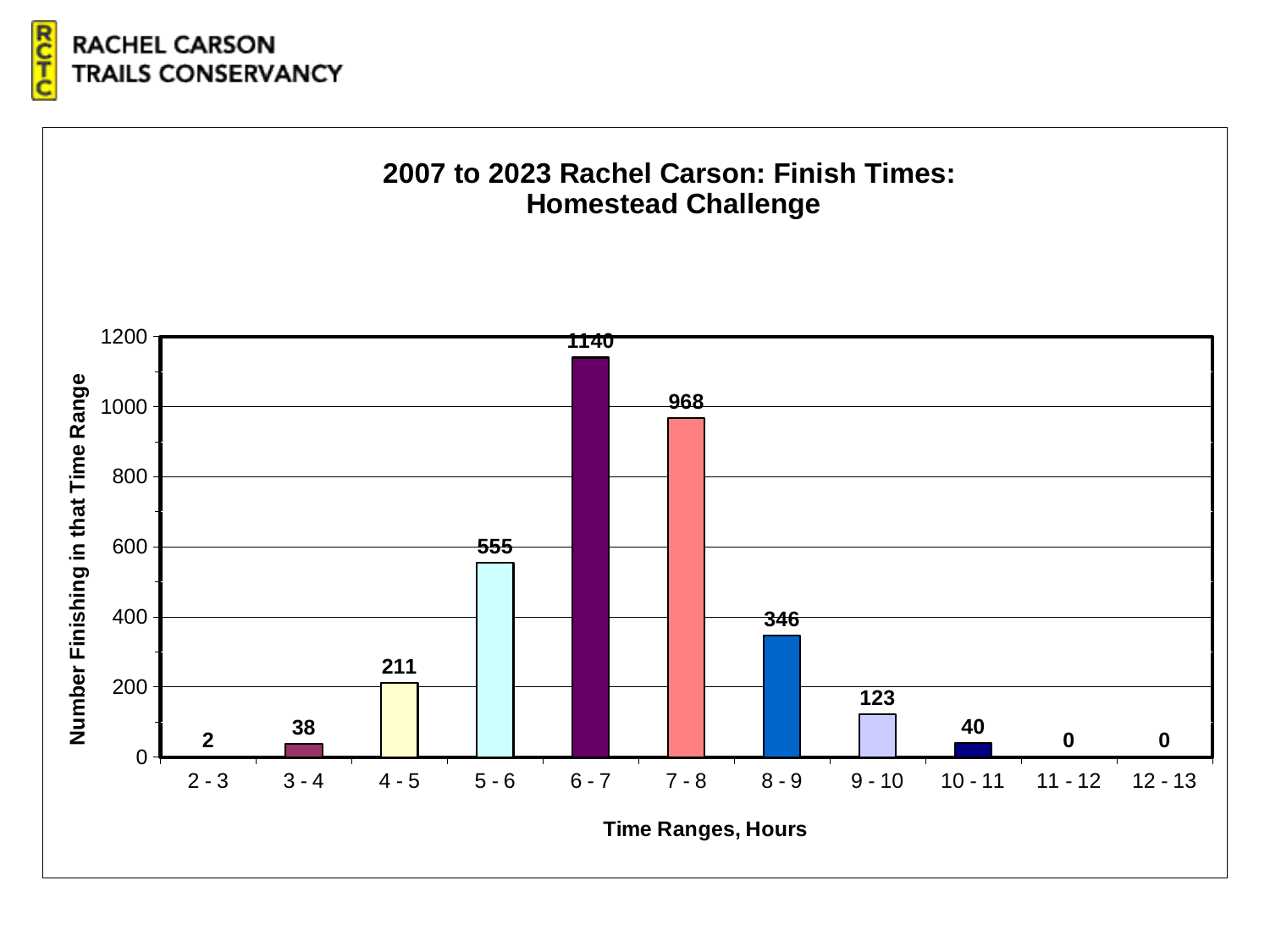
What is the title of the chart? 2007 to 2023 Rachel Carson: Finish Times: Homestead Challenge How many time range categories are shown on the x axis? 11 What is the difference between the number of finishers in the 6 - 7 and 7 - 8 hour ranges? 172 How many time ranges have 0 finishers? 2 Which time range has the highest number of finishers? 6 - 7 What is the number finishing in the 8 - 9 hour time range? 346 What is the difference between the number of finishers in the 9 - 10 and 10 - 11 hour ranges? 83 How many finishers are in the 6 - 7 hour time range? 1140 Which has more finishers, the 5 - 6 hour range or the 8 - 9 hour range? 5 - 6 What is the label of the y axis? Number Finishing in that Time Range What kind of chart is shown on the slide? Bar chart How many finishers are in the 4 - 5 hour time range? 211